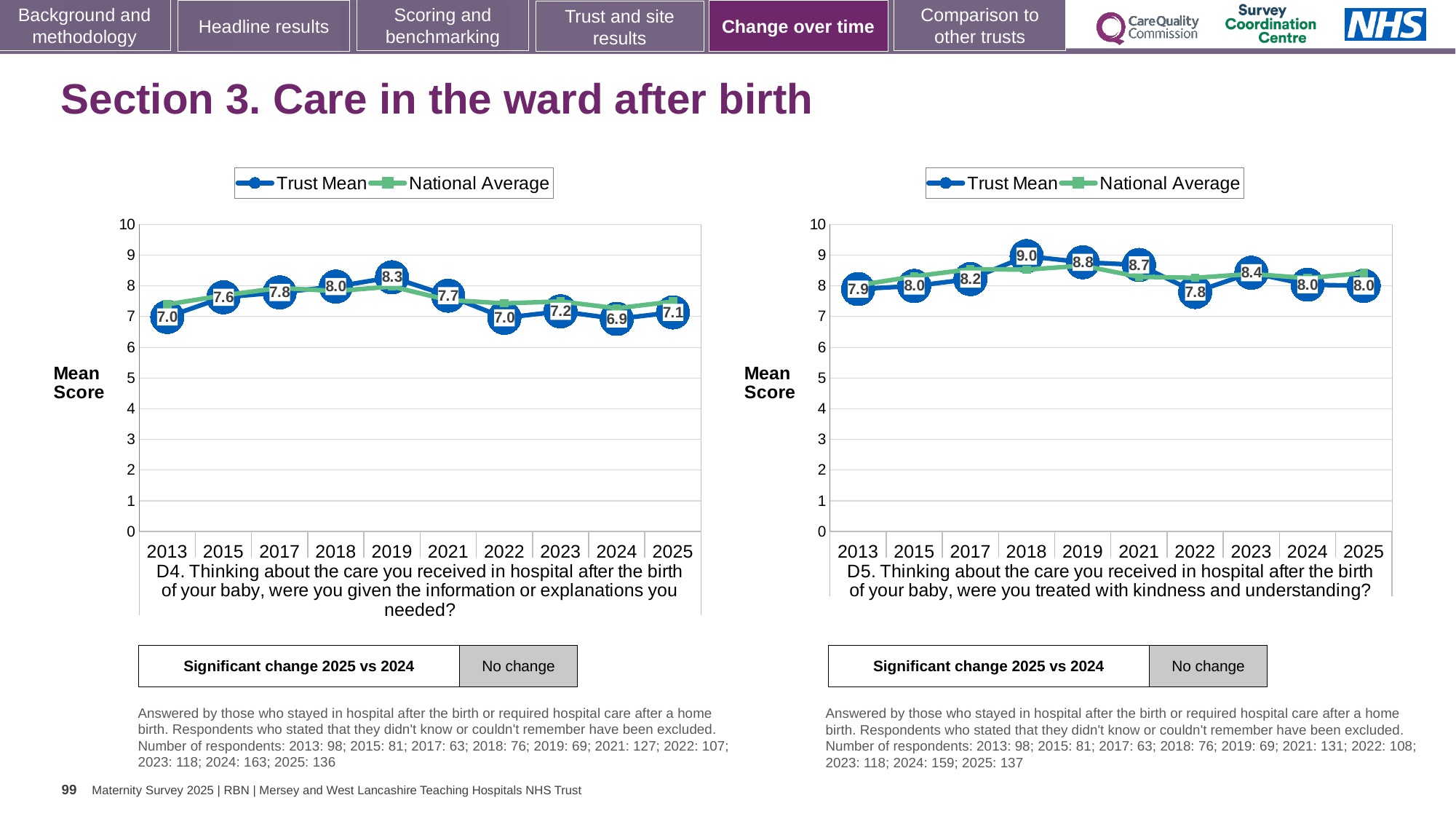
On the right chart (D5), what is the difference between the Trust Mean scores for 2018 and 2022? 1.2 On the left chart (D4), what is the Trust Mean score for 2025? 7.1 How many years are plotted on the x axis of the left chart (D4)? 10 How many series does the legend of the right chart (D5) list? 2 On the right chart (D5), what is the Trust Mean score for 2022? 7.8 On the right chart (D5), is the Trust Mean score higher in 2023 or in 2024? 2023 On the right chart (D5), which year has the highest Trust Mean score? 2018 On the right chart (D5), what is the Trust Mean score for 2018? 9.0 On the left chart (D4), which year has the lowest Trust Mean score? 2024 On the left chart (D4), what is the Trust Mean score for 2019? 8.3 On the left chart (D4), which year has the highest Trust Mean score? 2019 On the left chart (D4), what is the difference between the Trust Mean scores for 2019 and 2024? 1.4